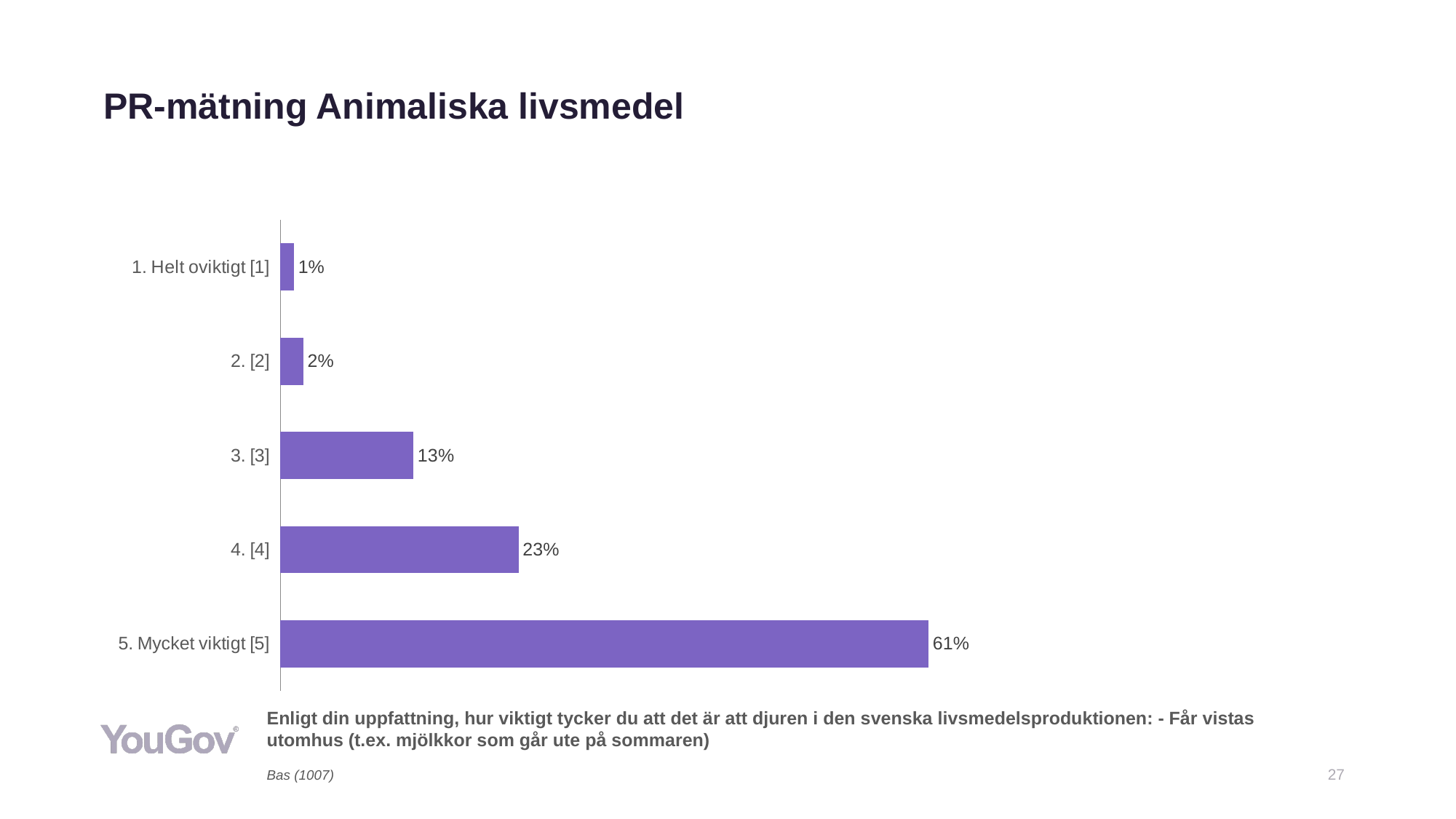
What is the difference between the values for "4. [4]" and "3. [3]"? 10% Which is larger, the value for "2. [2]" or the value for "3. [3]"? 3. [3] How many categories are shown in the chart? 5 What is the difference between the values for "5. Mycket viktigt [5]" and "4. [4]"? 38% Do the values increase or decrease going from category 1 down to category 5? Increase Which category has the highest value? 5. Mycket viktigt [5] What is the value shown for "1. Helt oviktigt [1]"? 1% What kind of chart is shown on the slide? Bar chart Which category has the lowest value? 1. Helt oviktigt [1] What is the value shown for "3. [3]"? 13% What is the base (Bas) size stated on the slide? 1007 What percentage of respondents answered "5. Mycket viktigt [5]"? 61%